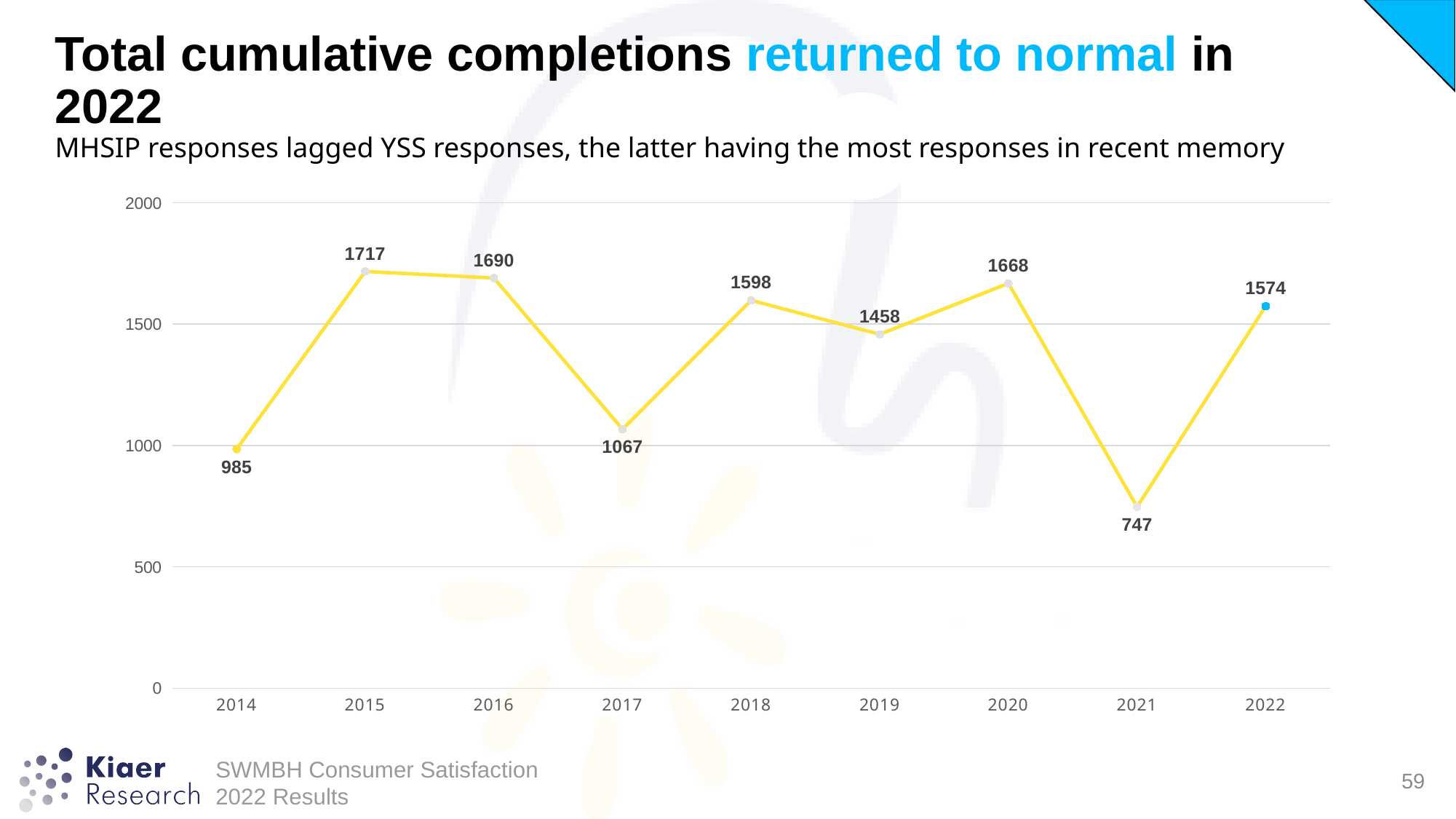
What was the total cumulative completions value in 2022? 1574 What was the total cumulative completions value in 2021? 747 What is the difference between the completions in 2015 and 2016? 27 Which year had more completions, 2018 or 2019? 2018 What is the difference between the completions in 2022 and 2021? 827 Which year had the highest total cumulative completions? 2015 Is the value for 2017 greater or less than 1000? greater What kind of chart is shown on the slide? Line chart Which year had the lowest total cumulative completions? 2021 How many years are plotted on the chart? 9 What was the total cumulative completions value in 2014? 985 Did the completions rise or fall from 2020 to 2021? Fall